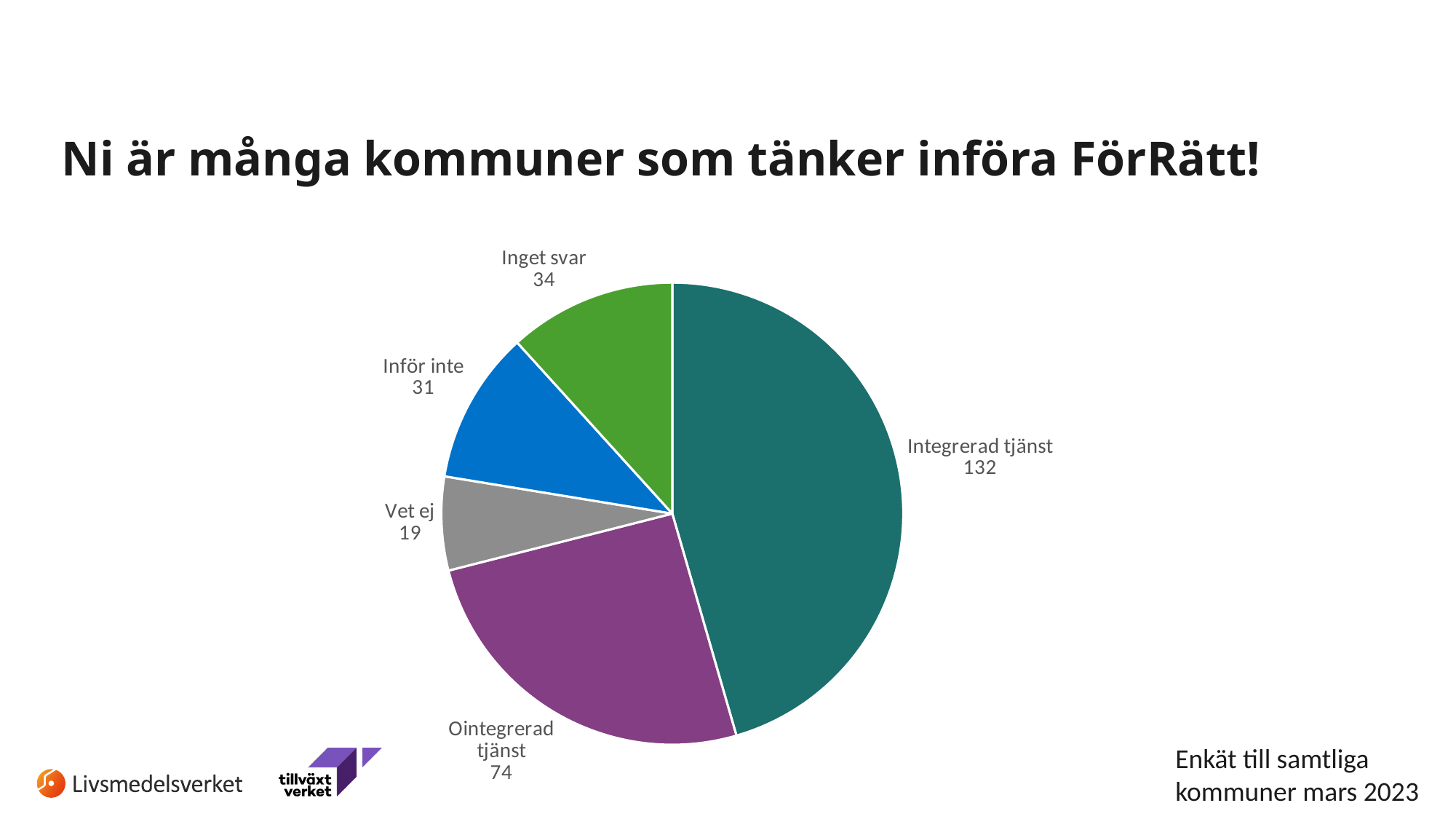
What is the value for Ointegrerad tjänst? 74 What kind of chart is shown on the slide? Pie chart What is the value for Integrerad tjänst? 132 Which category has the smallest slice? Vet ej What is the value for Inget svar? 34 What is the value for Vet ej? 19 What is the title of the slide containing the pie chart? Ni är många kommuner som tänker införa FörRätt! Which category has the largest slice? Integrerad tjänst How many slices does the pie chart have? 5 Which is larger, Inget svar or Inför inte? Inget svar What is the value for Inför inte? 31 What is the difference between Integrerad tjänst and Ointegrerad tjänst? 58